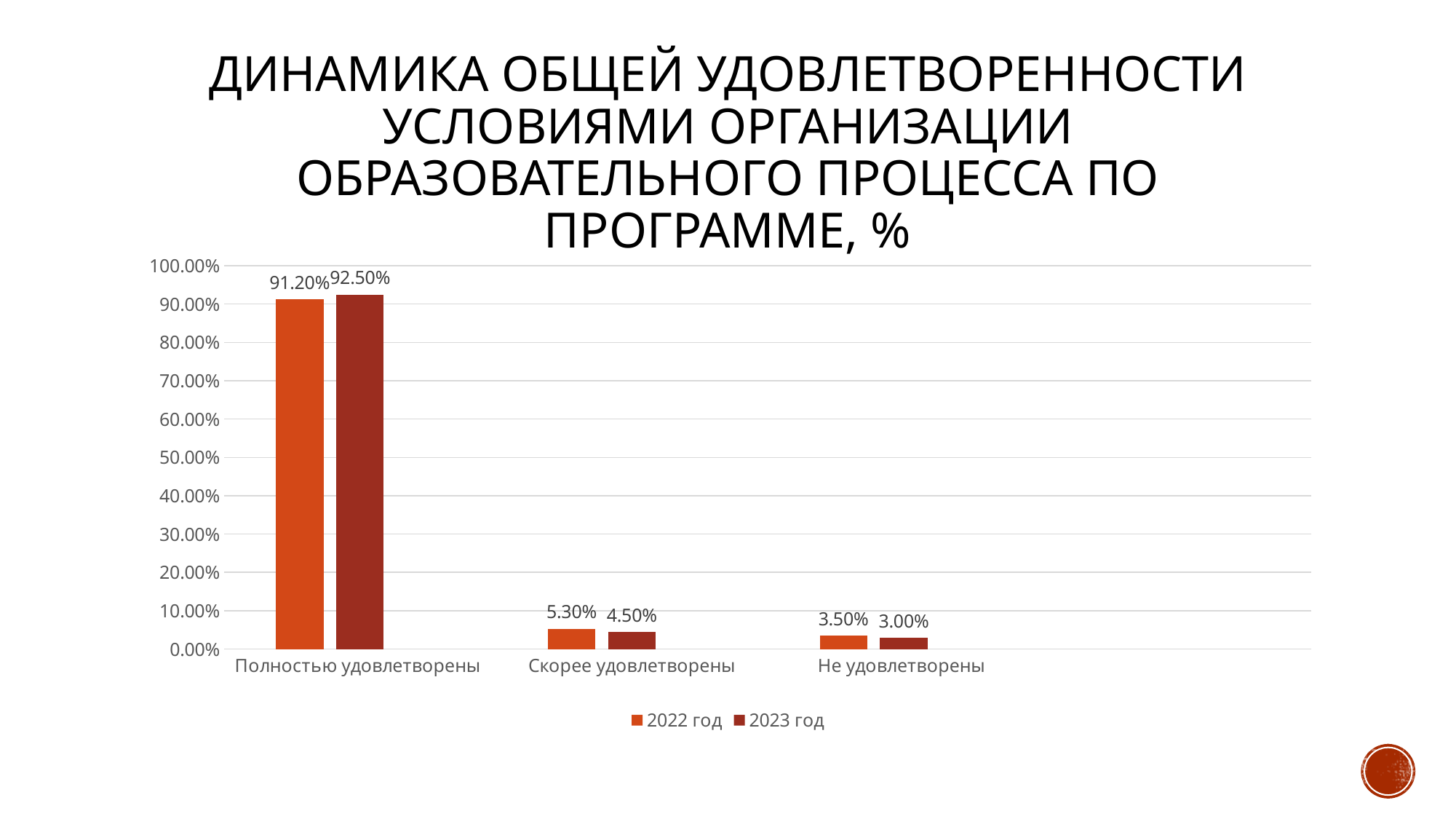
What is the value for "Полностью удовлетворены" in the 2023 год series? 92.50% Which series is shown in the darker red colour? 2023 год What is the value for "Не удовлетворены" in the 2023 год series? 3.00% What is the difference between the 2023 год and 2022 год values for "Полностью удовлетворены"? 1.30% How many series does the legend list? 2 What is the value for "Полностью удовлетворены" in the 2022 год series? 91.20% Which category has the highest value in the 2023 год series? Полностью удовлетворены Which category has the lowest value in the 2022 год series? Не удовлетворены What kind of chart is shown on the slide? Bar chart How many categories are shown on the x axis? 3 What is the value for "Скорее удовлетворены" in the 2022 год series? 5.30% Which is larger for "Скорее удовлетворены": the 2022 год value or the 2023 год value? 2022 год